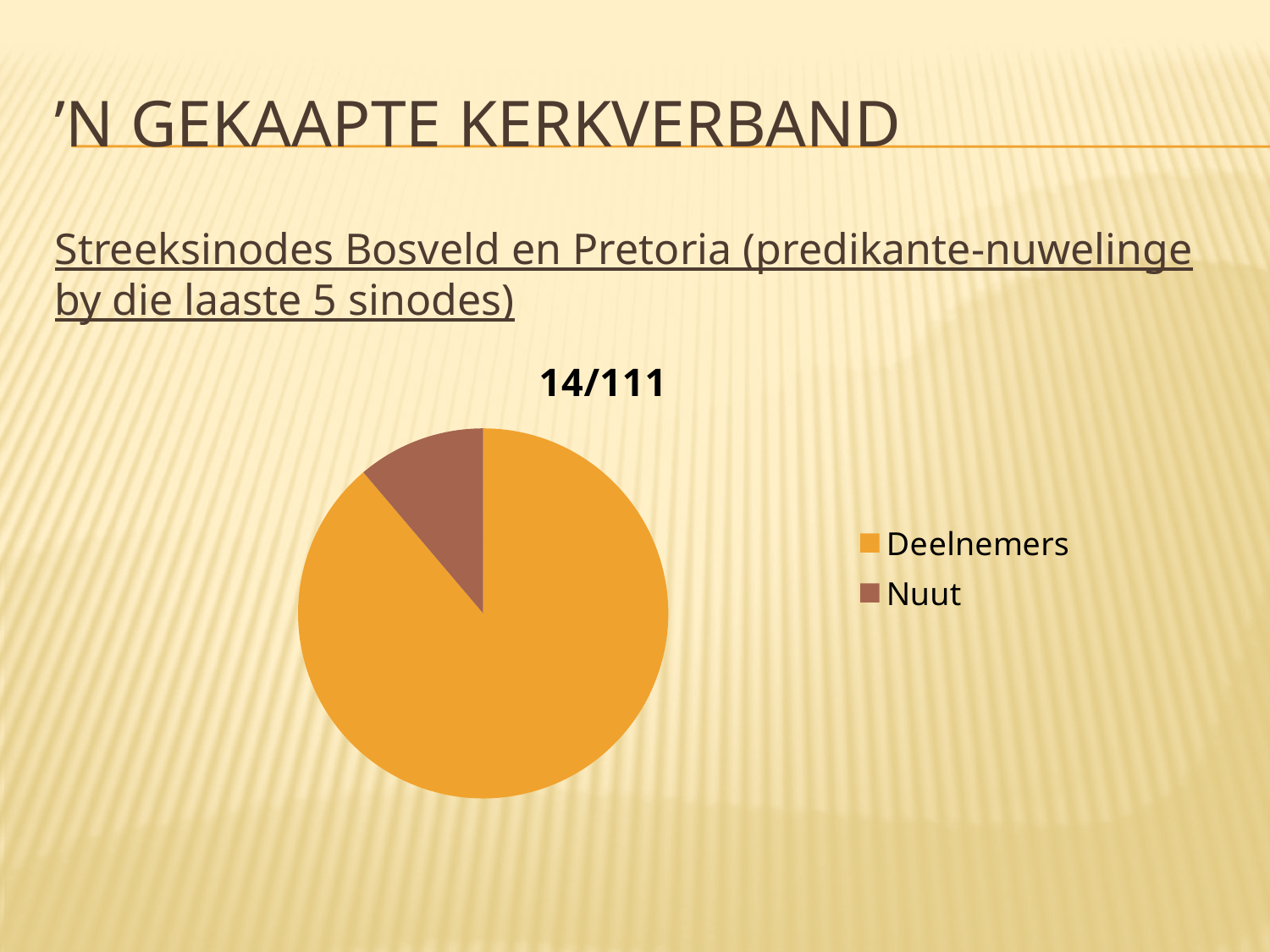
How many entries does the legend of the pie chart list? 2 Which category has the largest slice in the pie chart? Deelnemers Which slice is larger in the pie chart, Deelnemers or Nuut? Deelnemers How many slices does the pie chart have? 2 What kind of chart is shown on the slide? pie chart What colour is the Nuut slice in the pie chart? brown What is the title of the pie chart? 14/111 Which category has the smallest slice in the pie chart? Nuut